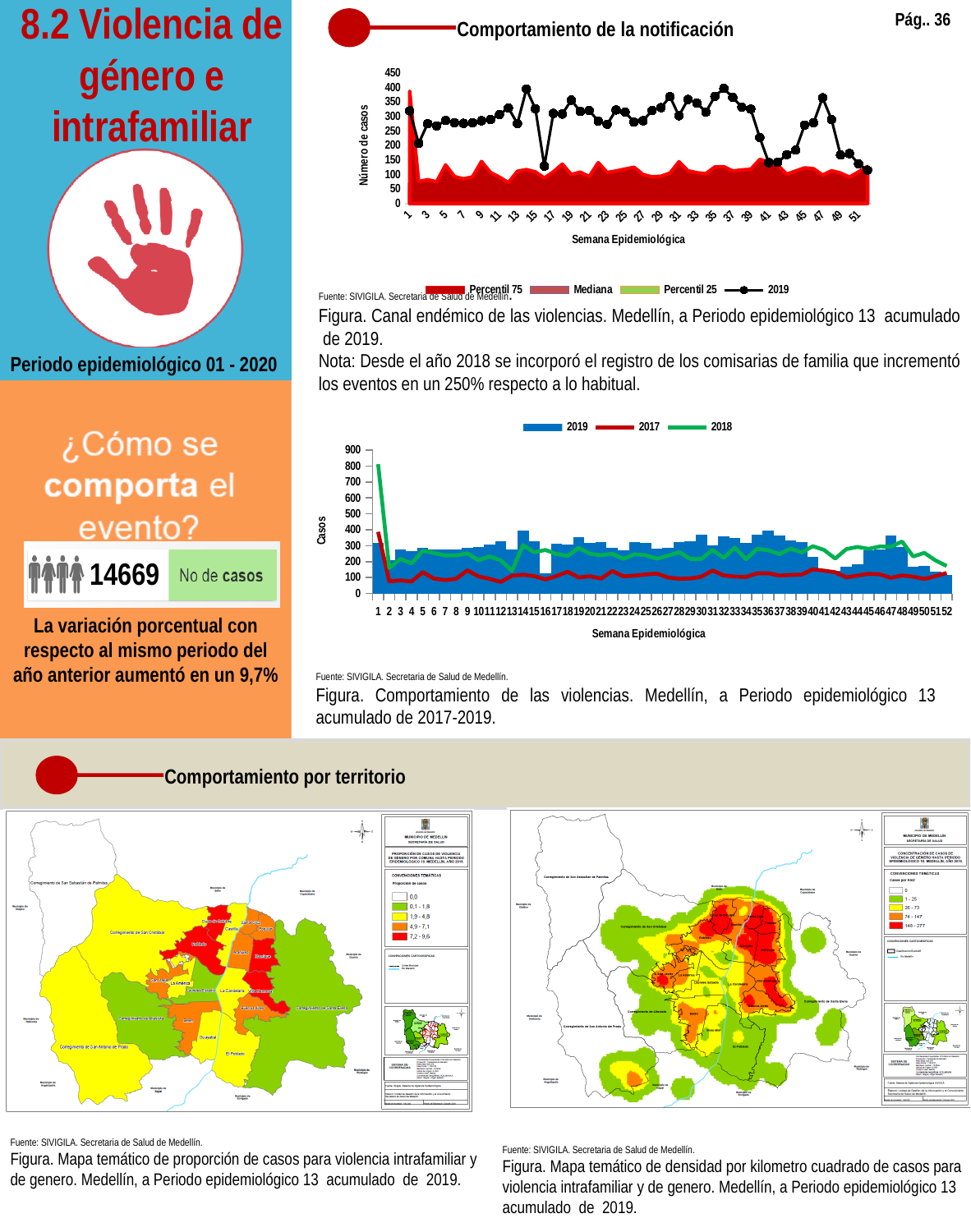
How many series does the legend of the top chart (Canal endémico de las violencias) list? 4 In the bottom chart (Comportamiento de las violencias), how many epidemiological weeks are shown on the x axis? 52 In the top chart (Canal endémico de las violencias), is the 2019 value at week 1 greater or less than 250? greater In the bottom chart (Comportamiento de las violencias), is the 2018 value at week 1 greater or less than 600? greater In the bottom chart (Comportamiento de las violencias), does the 2018 line rise or fall from week 1 to week 2? fall In the top chart (Canal endémico de las violencias), is the 2019 value at week 36 greater or less than 300? greater How many series does the legend of the bottom chart (Comportamiento de las violencias) list? 3 In the bottom chart (Comportamiento de las violencias), which series has the highest value at week 1? 2018 In the bottom chart (Comportamiento de las violencias), what colour is the 2018 line? Green What is the label of the y axis of the top chart (Canal endémico de las violencias)? Número de casos In the bottom chart (Comportamiento de las violencias), which series is drawn as bars? 2019